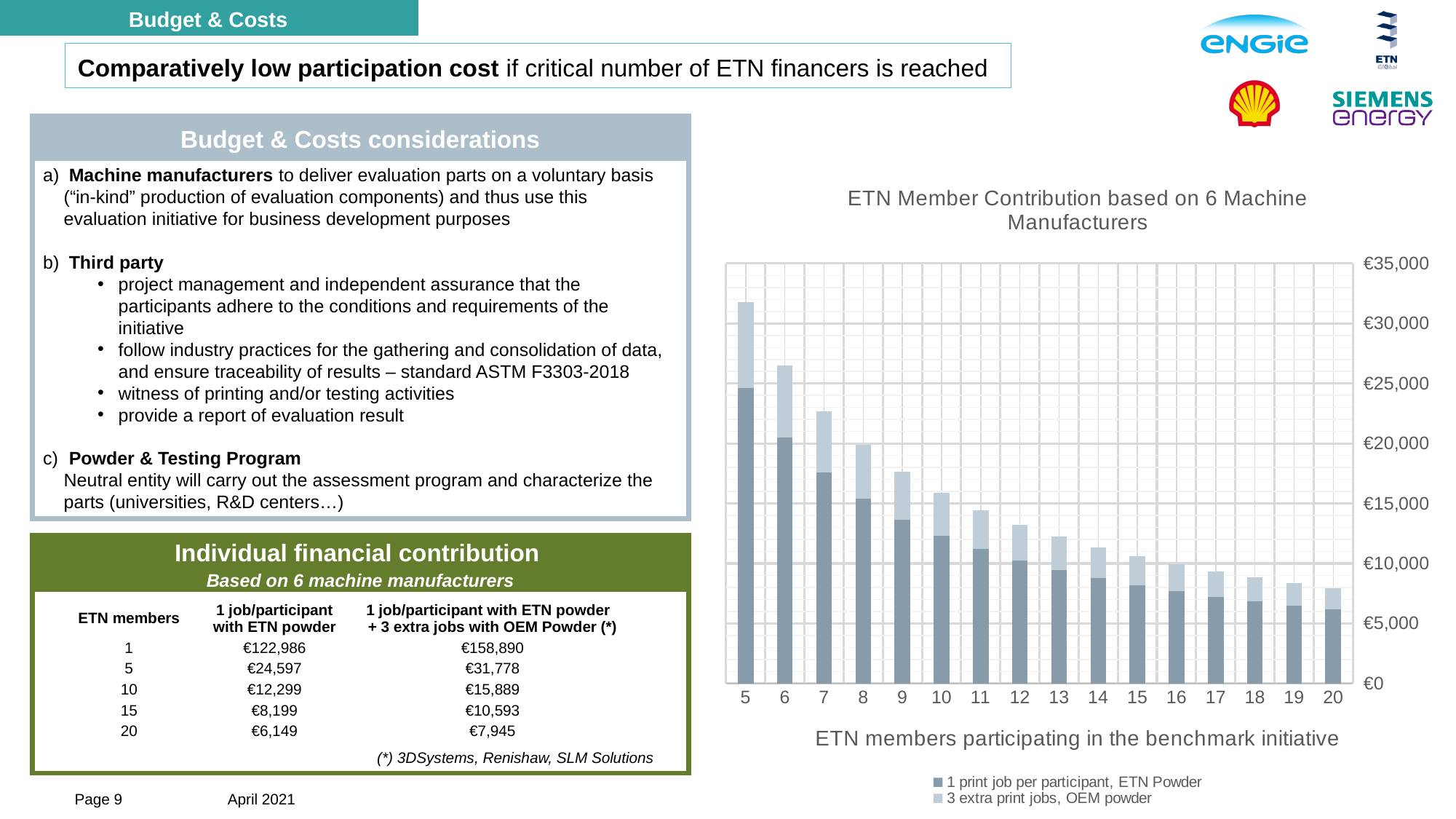
Which number of ETN members has the highest total contribution in the chart? 5 Is the total stacked bar for 20 ETN members greater or less than €10,000? less Which is larger: the total bar for 8 ETN members or the total bar for 12 ETN members? 8 ETN members Is the '1 print job per participant, ETN Powder' value for 5 ETN members greater or less than €20,000? greater Do the bar heights rise or fall as the number of ETN members increases along the x axis? fall Which number of ETN members has the lowest total contribution in the chart? 20 What is the title of the chart? ETN Member Contribution based on 6 Machine Manufacturers What kind of chart is shown on the slide? stacked bar chart Is the total stacked bar for 5 ETN members greater or less than €30,000? greater How many categories are shown along the x axis of the chart? 16 How many series does the chart legend list? 2